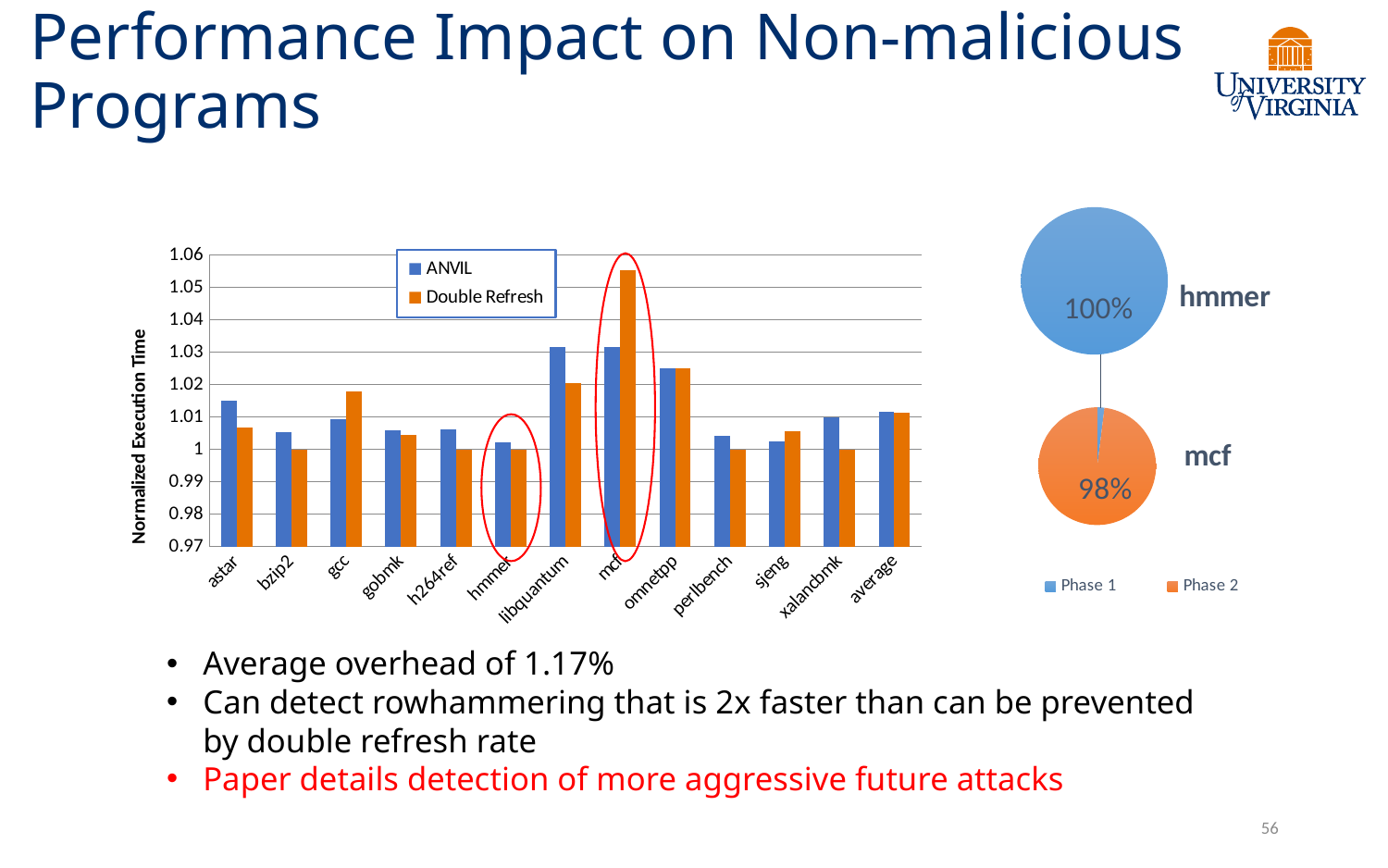
What is the y-axis title of the bar chart on the left? Normalized Execution Time In the bar chart on the left, is the Double Refresh value for mcf greater or less than 1.04? greater In the bar chart on the left, is the Double Refresh value for bzip2 greater or less than 1.01? less In the bar chart on the left, how many series does the legend list? 2 In the pie chart labeled hmmer on the right, what percentage is printed on the pie? 100% What kind of chart is the chart on the left of the slide? bar chart In the bar chart on the left, for astar, which series has the larger value, ANVIL or Double Refresh? ANVIL In the pie chart labeled mcf on the right, what percentage is printed on the pie? 98% In the bar chart on the left, is the ANVIL value for libquantum greater or less than 1.02? greater In the bar chart on the left, for mcf, which series has the larger value, ANVIL or Double Refresh? Double Refresh In the bar chart on the left, how many categories are shown on the x axis? 13 In the bar chart on the left, which category has the highest Double Refresh value? mcf